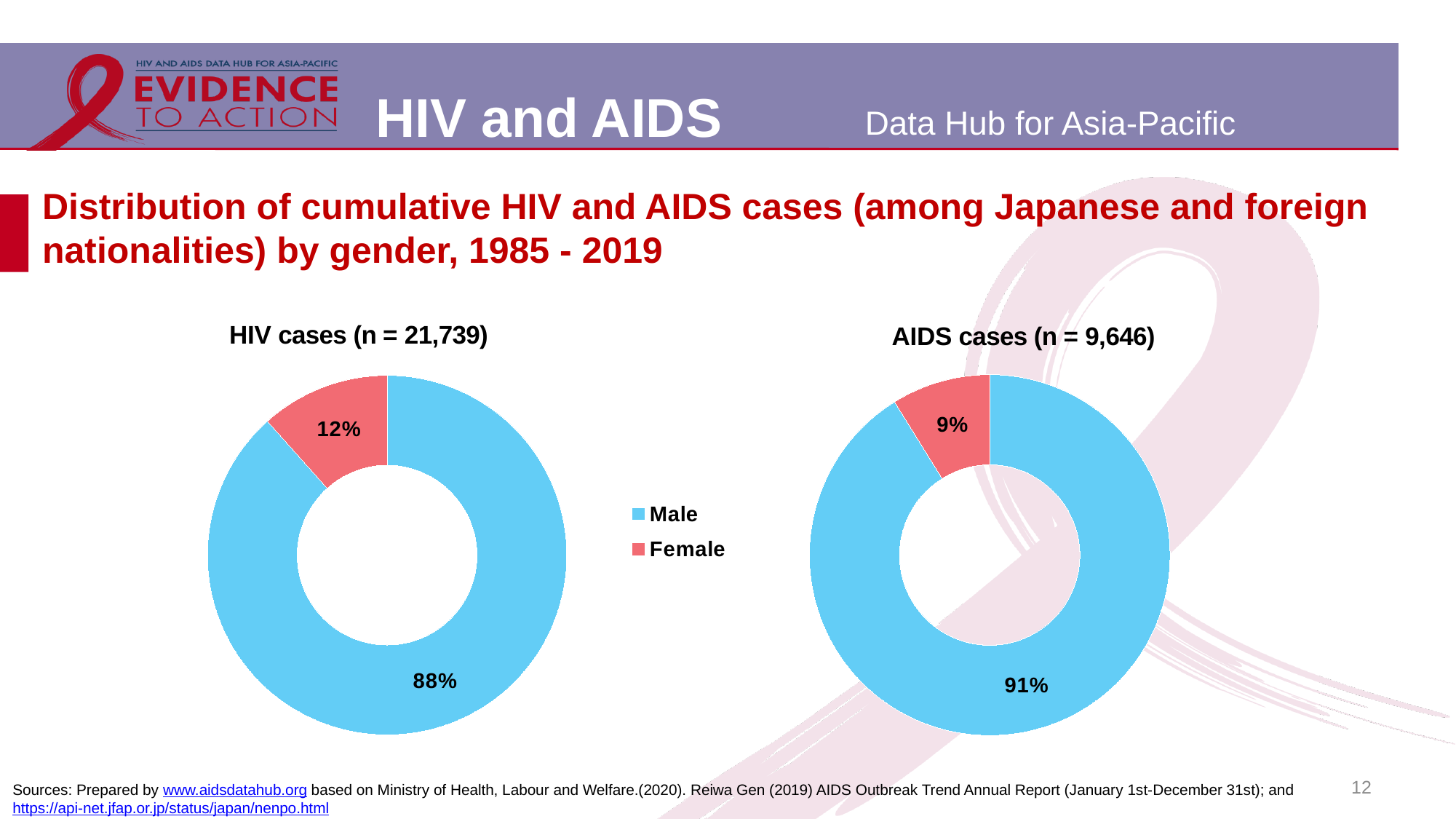
In the 'AIDS cases (n = 9,646)' chart, what share of cases is Female? 9% What kind of chart is the 'AIDS cases (n = 9,646)' chart? Doughnut (pie) chart In the 'HIV cases (n = 21,739)' chart, what is the difference between the Male and Female shares? 76% In the 'HIV cases (n = 21,739)' chart, what share of cases is Female? 12% Is the Female share larger in the 'HIV cases (n = 21,739)' chart or the 'AIDS cases (n = 9,646)' chart? HIV cases (n = 21,739) How many categories does the 'HIV cases (n = 21,739)' chart show? 2 How many entries does the legend list? 2 What colour represents Female in the charts? Red In the 'AIDS cases (n = 9,646)' chart, which gender has the smallest share? Female In the 'HIV cases (n = 21,739)' chart, what share of cases is Male? 88% In the 'HIV cases (n = 21,739)' chart, which gender has the largest share? Male